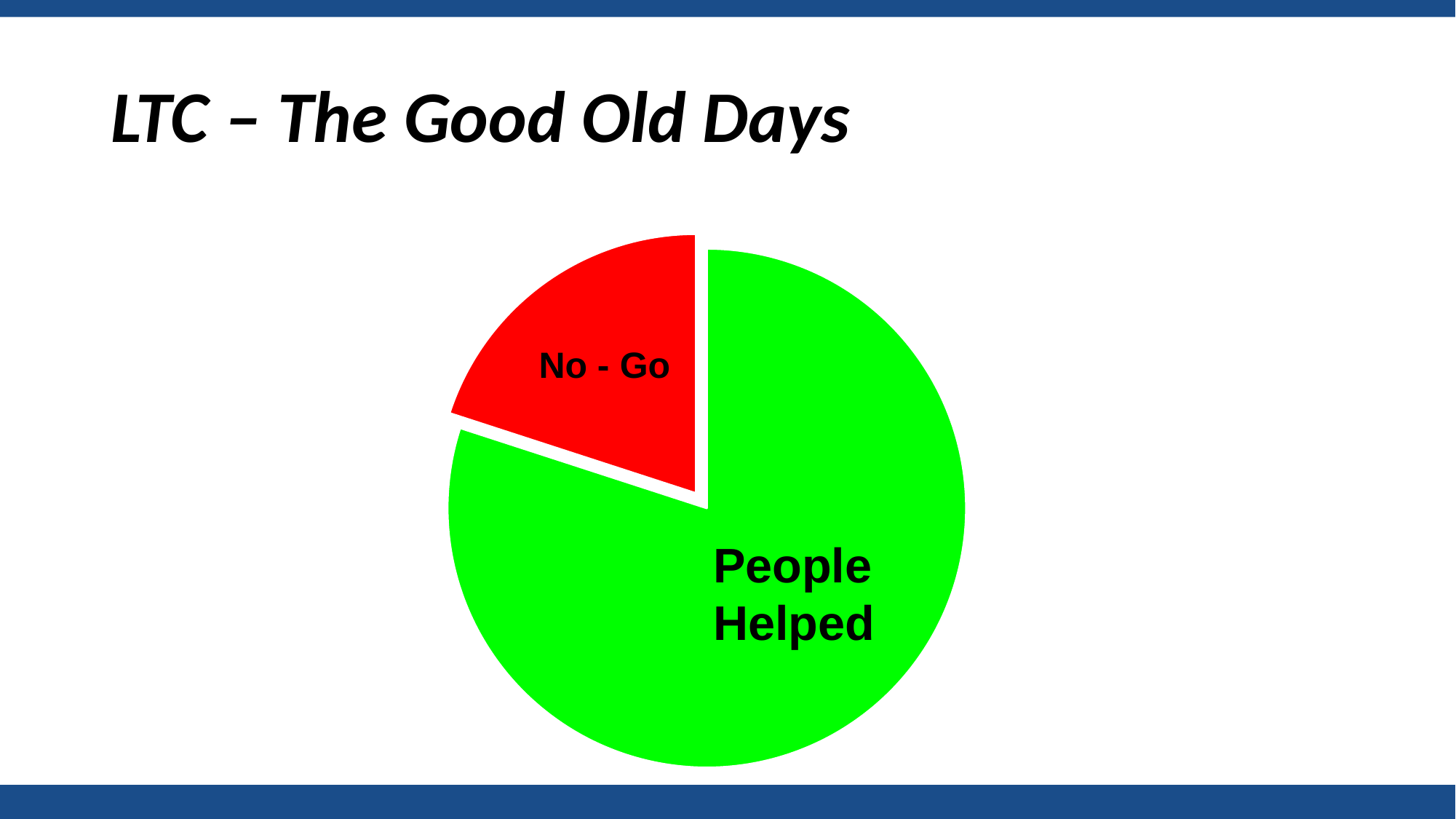
Which slice of the pie chart is the smallest? No - Go Which slice is larger, "No - Go" or "People Helped"? People Helped What is the title of the slide containing the pie chart? LTC – The Good Old Days What colour is the "People Helped" slice? green Which slice of the pie chart is the largest? People Helped What colour is the "No - Go" slice? red How many slices does the pie chart have? 2 What kind of chart is shown on the slide? pie chart